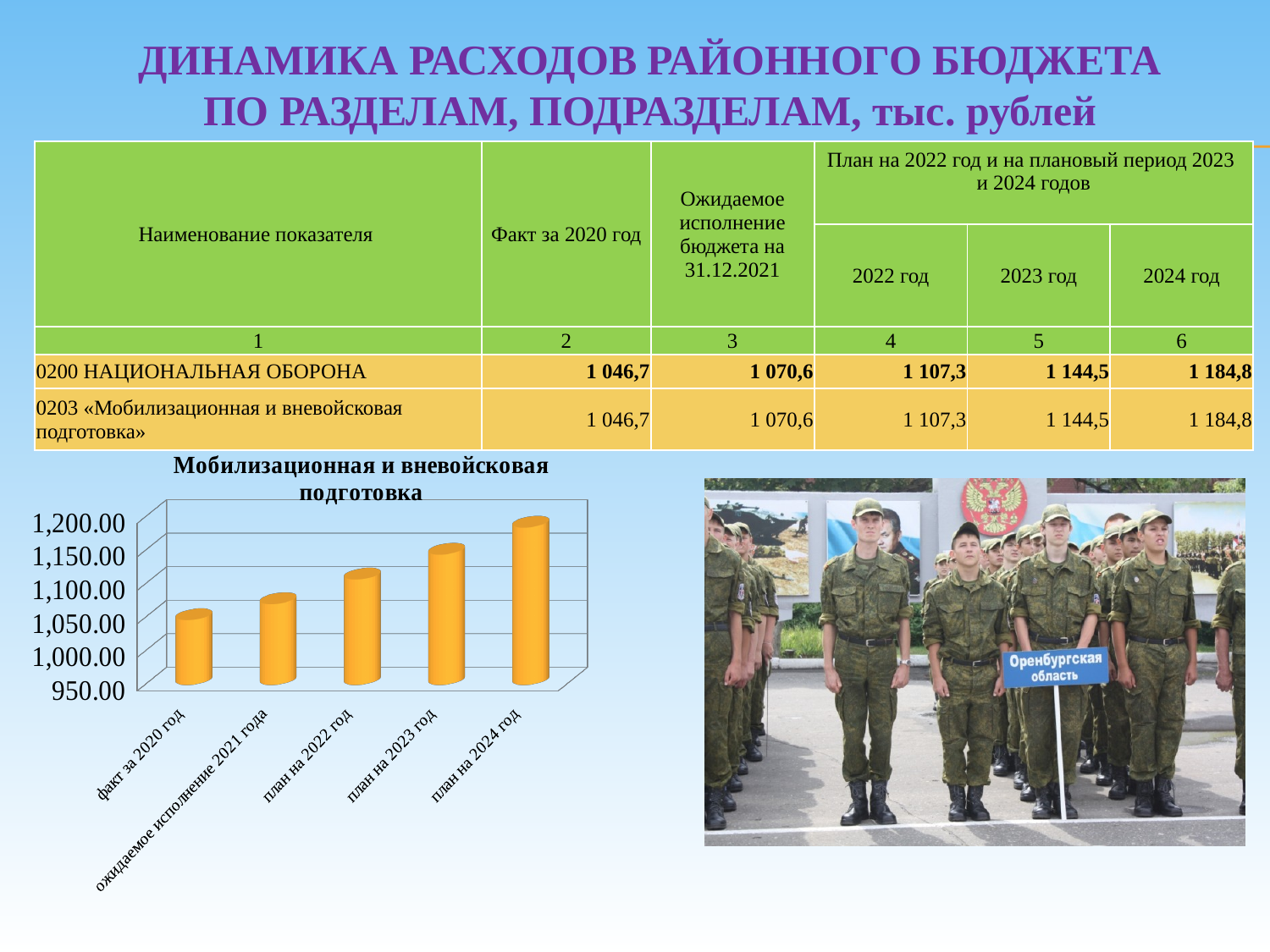
What kind of chart is shown on the slide? bar chart Which category has the highest bar in the chart? план на 2024 год Is the value for план на 2024 год greater or less than 1,150.00? greater Is the value for ожидаемое исполнение 2021 года greater or less than 1,100.00? less Which is larger in the chart, план на 2023 год or план на 2022 год? план на 2023 год How many bars does the chart have? 5 Is the value for факт за 2020 год greater or less than 1,100.00? less What is the title of the chart? Мобилизационная и вневойсковая подготовка Which category has the lowest bar in the chart? факт за 2020 год What is the lowest tick value shown on the chart's vertical axis? 950.00 Do the values in the chart rise or fall from left to right? rise